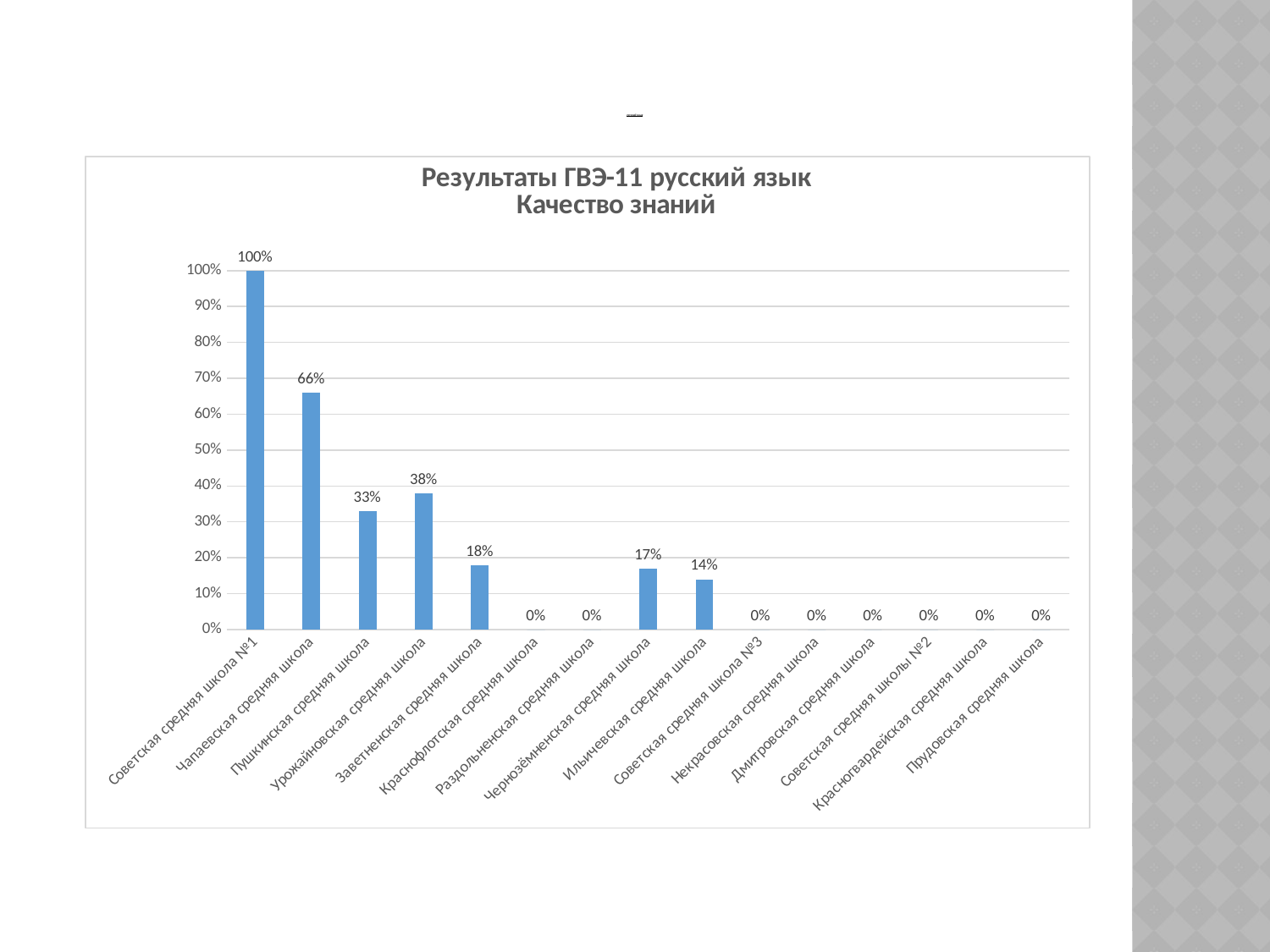
What is the value for Чернозёмненская средняя школа? 17% How many schools are shown on the x axis? 15 Is the value for Пушкинская средняя школа greater or less than 40%? less What is the value for Урожайновская средняя школа? 38% Which is larger, the value for Заветненская средняя школа or the value for Ильичевская средняя школа? Заветненская средняя школа What kind of chart is this? bar chart Which school has the highest value? Советская средняя школа №1 What is the difference between the values for Урожайновская средняя школа and Пушкинская средняя школа? 5% What is the difference between the values for Советская средняя школа №1 and Чапаевская средняя школа? 34% What is the value for Ильичевская средняя школа? 14% What is the value for Чапаевская средняя школа? 66% What is the title of the chart? Результаты ГВЭ-11 русский язык Качество знаний